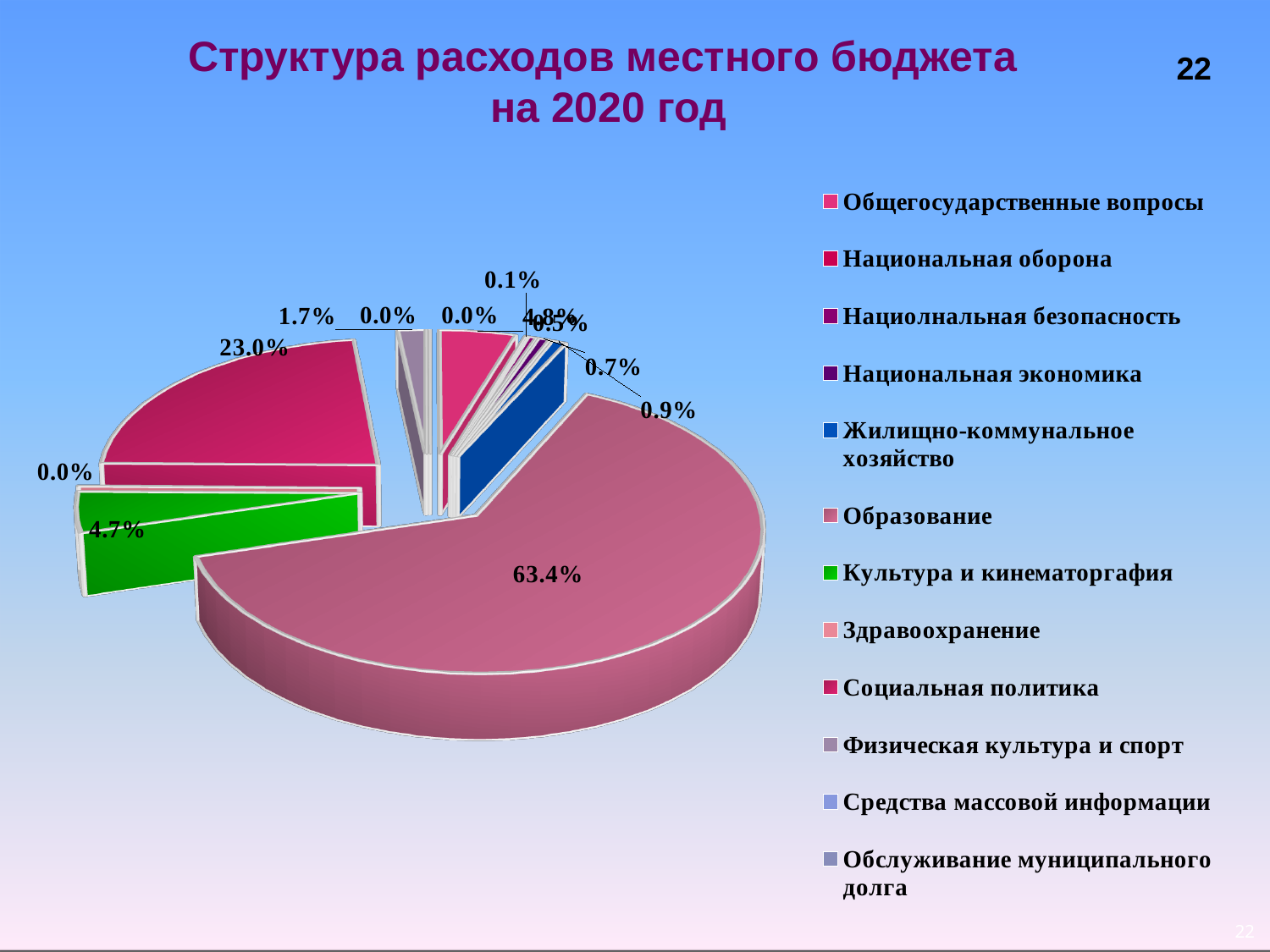
What colour is the slice for Культура и кинематография? green What share of the pie does Культура и кинематография take? 4.7% How many entries does the legend list? 12 What kind of chart is shown on the slide? pie chart What is the difference between the shares of Образование and Социальная политика? 40.4% Which is larger, the slice for Социальная политика or the slice for Культура и кинематография? Социальная политика Which category has the largest slice of the pie? Образование What share of the pie does Социальная политика take? 23.0% What share of the pie does Образование take? 63.4% Which is larger, the slice for Образование or the slice for Социальная политика? Образование What is the difference between the shares of Социальная политика and Культура и кинематография? 18.3% What is the title of the chart? Структура расходов местного бюджета на 2020 год